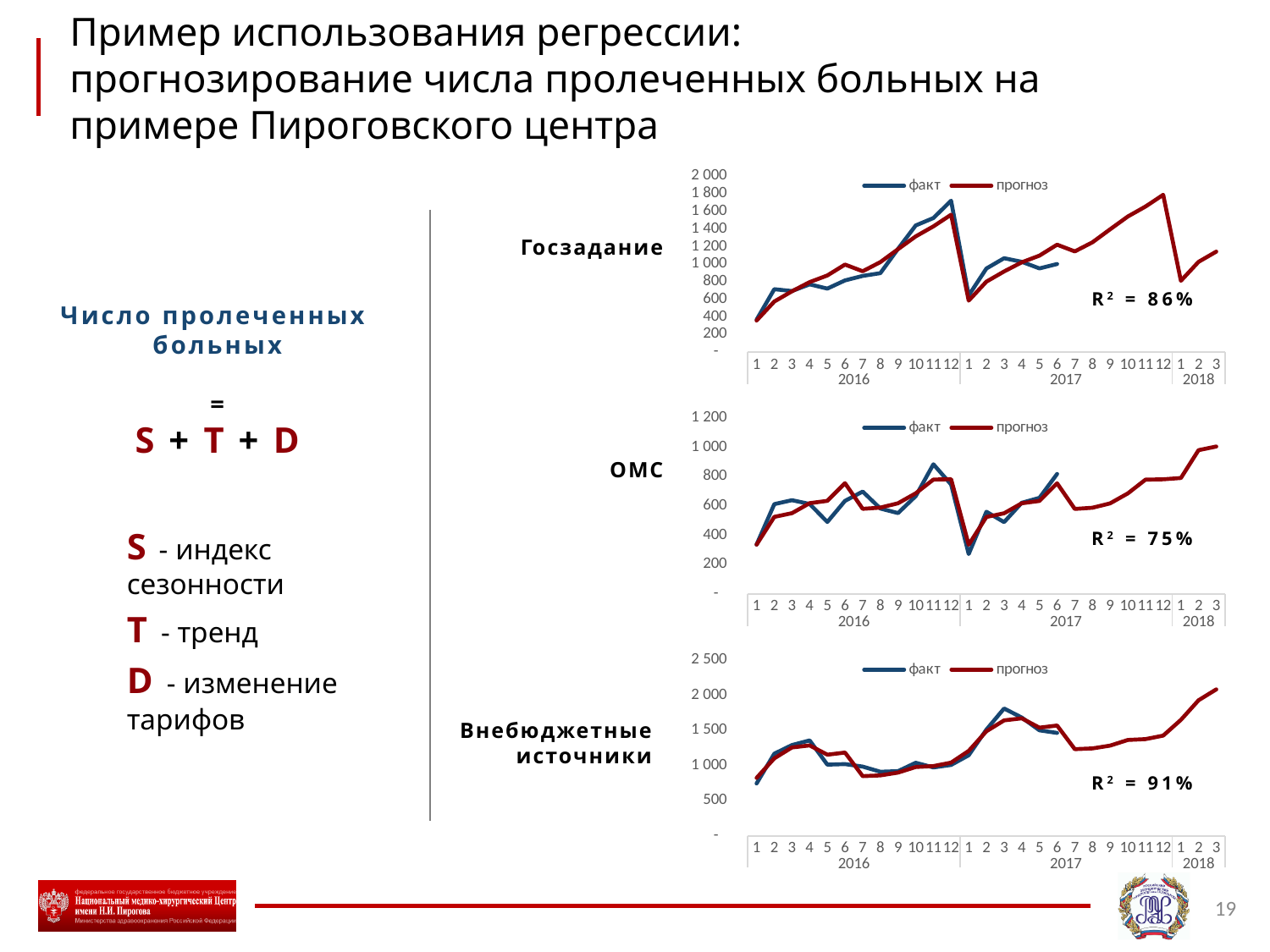
What R² value is printed on the Госзадание chart? 86% In the ОМС chart, is the факт value for month 1 of 2017 greater or less than 400? less What R² value is printed on the Внебюджетные источники chart? 91% How many charts are shown on the slide? 3 In the Внебюджетные источники chart, is the прогноз value for month 3 of 2018 greater or less than 1500? greater What R² value is printed on the ОМС chart? 75% In the Внебюджетные источники chart, does the прогноз line rise or fall across the months of 2018? rise In the Госзадание chart, is the прогноз value for month 12 of 2017 greater or less than 1400? greater Which of the three charts has the highest printed R² value? Внебюджетные источники In the ОМС chart, how many series does the legend list? 2 In the Внебюджетные источники chart, what are the two legend entries? факт, прогноз What kind of chart is used for the Госзадание data? line chart